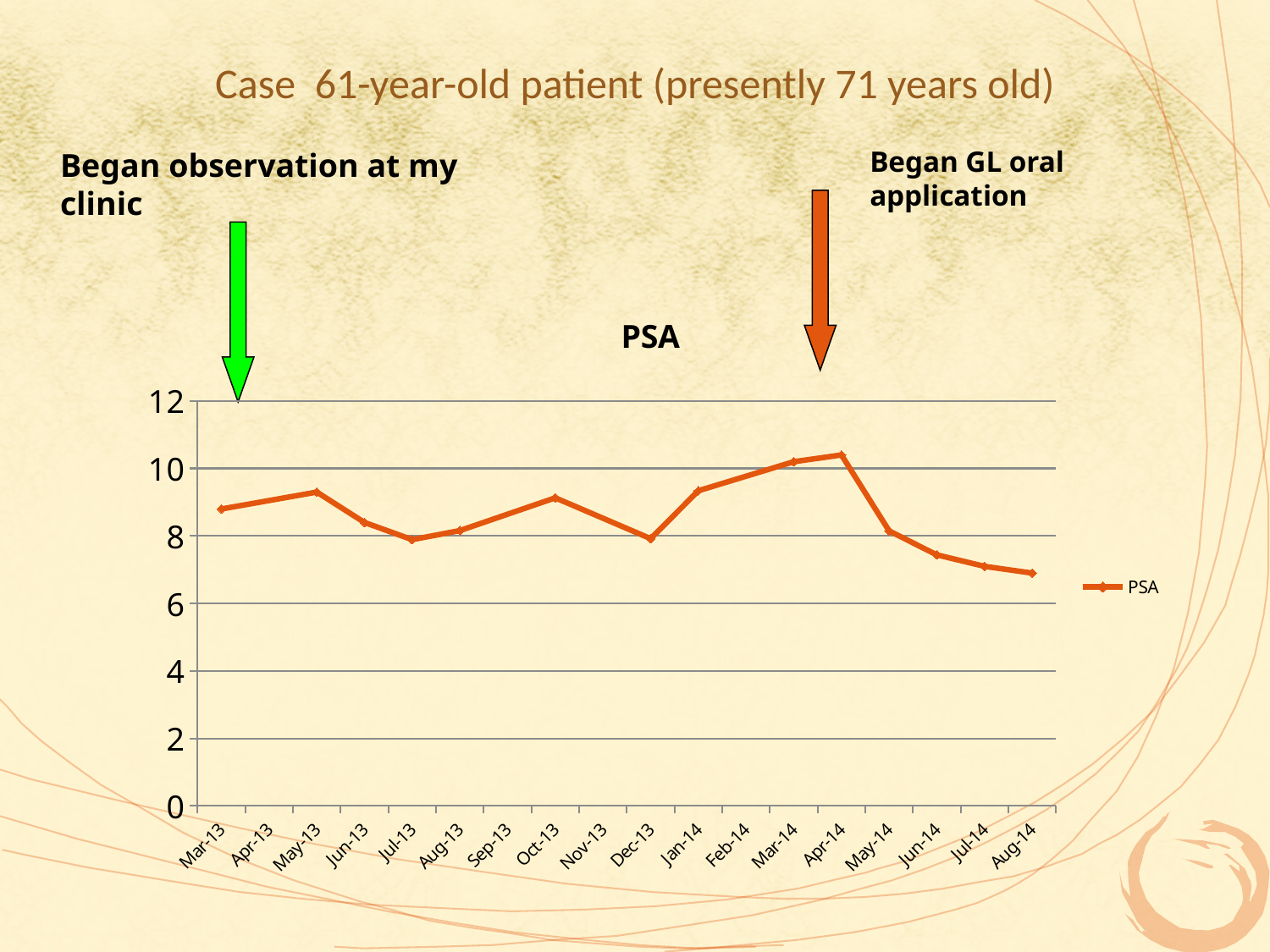
Is the PSA value for Jun-14 greater or less than 8? less How many months are plotted along the x axis? 18 Is the PSA value for Jan-14 greater or less than 8? greater Which month has the highest PSA value? Apr-14 What is the title of the chart? PSA Is the PSA value for Aug-14 greater or less than 8? less Which has the larger PSA value, Apr-14 or Aug-14? Apr-14 Between Apr-14 and Aug-14, do the PSA values rise or fall? fall Which has the larger PSA value, Oct-13 or Dec-13? Oct-13 What kind of chart is shown on the slide? line chart How many series does the legend list? 1